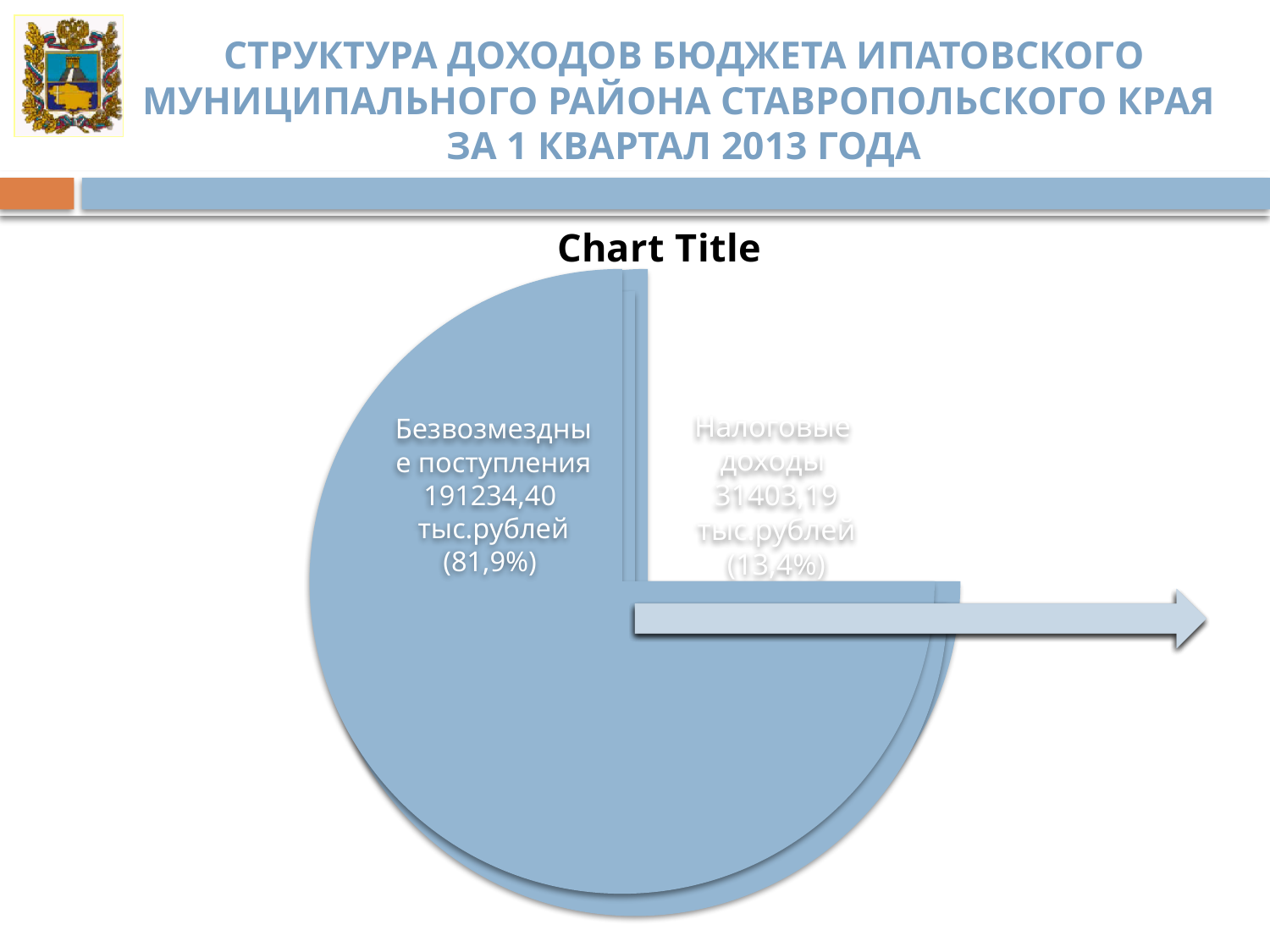
Is the value for Безвозмездные поступления greater or less than 100000 тыс.рублей? greater Which is larger, Безвозмездные поступления or Налоговые доходы? Безвозмездные поступления What share of the pie does Безвозмездные поступления represent? 81,9% What value is shown for Налоговые доходы? 31403,19 тыс.рублей What kind of chart is shown on the slide? pie chart Which labelled slice of the pie is the largest? Безвозмездные поступления What is the title printed above the chart? Chart Title What value is shown for Безвозмездные поступления? 191234,40 тыс.рублей What is the difference between Безвозмездные поступления and Налоговые доходы in тыс.рублей? 159831,21 тыс.рублей What share of the pie does Налоговые доходы represent? 13,4% Is the share of Налоговые доходы greater or less than 50%? less